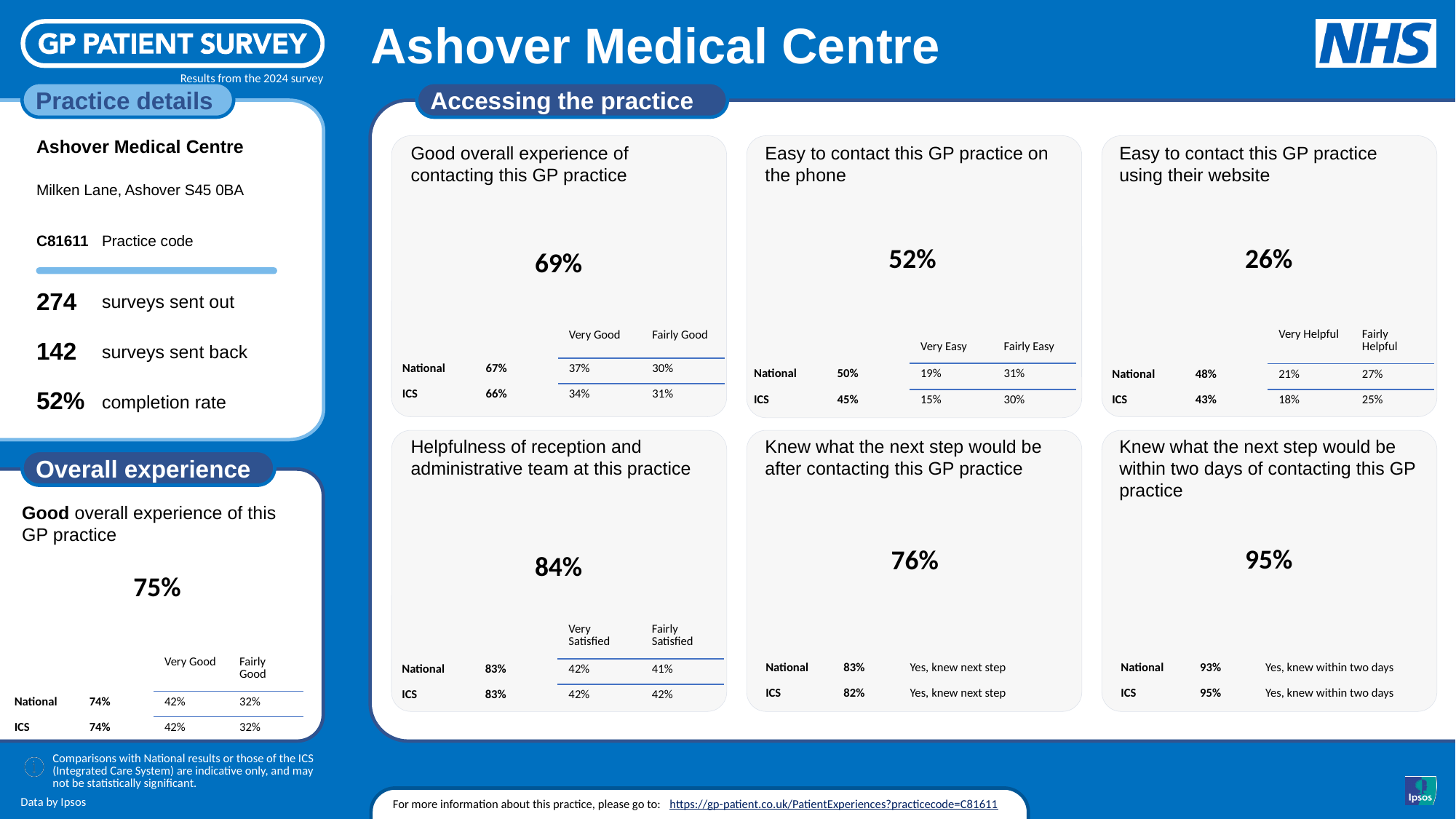
In the 'Easy to contact this GP practice on the phone' panel, what is the difference between the practice's headline value and the National value? 2% In the 'Easy to contact this GP practice using their website' panel, what is the practice's headline value? 26% Which of the six 'Accessing the practice' panels shows the highest practice headline value? Knew what the next step would be within two days of contacting this GP practice In the 'Knew what the next step would be after contacting this GP practice' panel, what is the ICS value? 82% In the 'Easy to contact this GP practice on the phone' panel, what is the practice's headline value? 52% In the 'Helpfulness of reception and administrative team at this practice' panel, what is the National value? 83% In the 'Good overall experience of this GP practice' panel under Overall experience, what is the practice's headline value? 75% In the 'Good overall experience of contacting this GP practice' panel, what is the ICS 'Very Good' value? 34% In the 'Good overall experience of contacting this GP practice' panel, what is the practice's headline value? 69% In the 'Knew what the next step would be within two days of contacting this GP practice' panel, what is the practice's headline value? 95% In the 'Easy to contact this GP practice using their website' panel, which is larger: the practice's headline value or the National value? National Which of the six 'Accessing the practice' panels shows the lowest practice headline value? Easy to contact this GP practice using their website